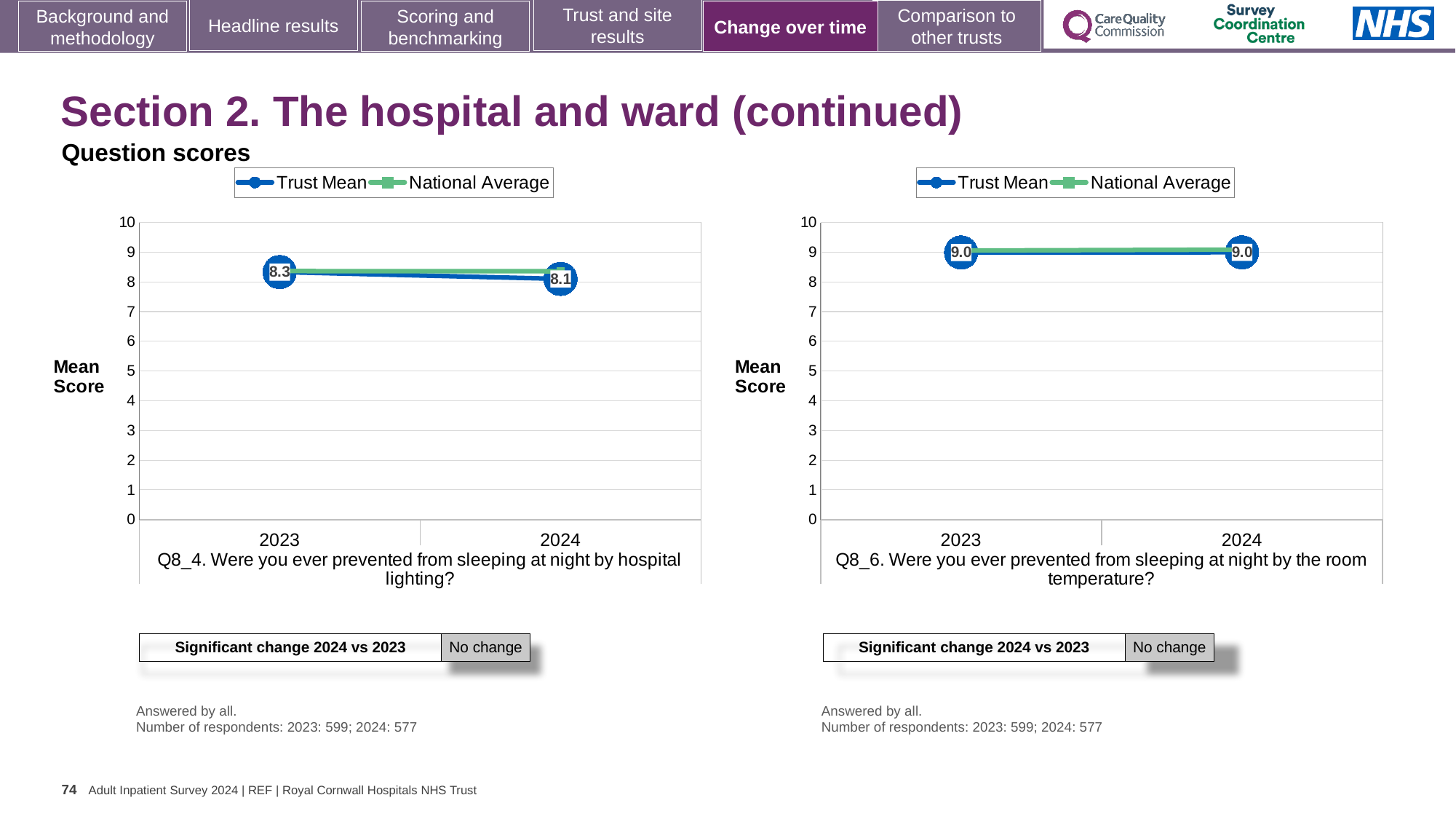
How many years are shown on the x axis of the left chart (Q8_4, hospital lighting)? 2 In the left chart (Q8_4, hospital lighting), which year has the higher Trust Mean score, 2023 or 2024? 2023 In the left chart (Q8_4, hospital lighting), what is the Trust Mean score for 2023? 8.3 What kind of chart is the left chart (Q8_4, hospital lighting)? line chart In the right chart (Q8_6, room temperature), what is the Trust Mean score for 2023? 9.0 In the right chart (Q8_6, room temperature), what is the Trust Mean score for 2024? 9.0 How many series does the legend of the right chart (Q8_6, room temperature) list? 2 In the left chart (Q8_4, hospital lighting), what is the Trust Mean score for 2024? 8.1 In the left chart (Q8_4, hospital lighting), does the Trust Mean rise or fall from 2023 to 2024? fall In the left chart (Q8_4, hospital lighting), by how much did the Trust Mean change from 2023 to 2024? decreased by 0.2 In the right chart (Q8_6, room temperature), does the Trust Mean rise, fall or stay the same from 2023 to 2024? stay the same In the left chart (Q8_4, hospital lighting), is the National Average for 2024 greater or less than 7? greater